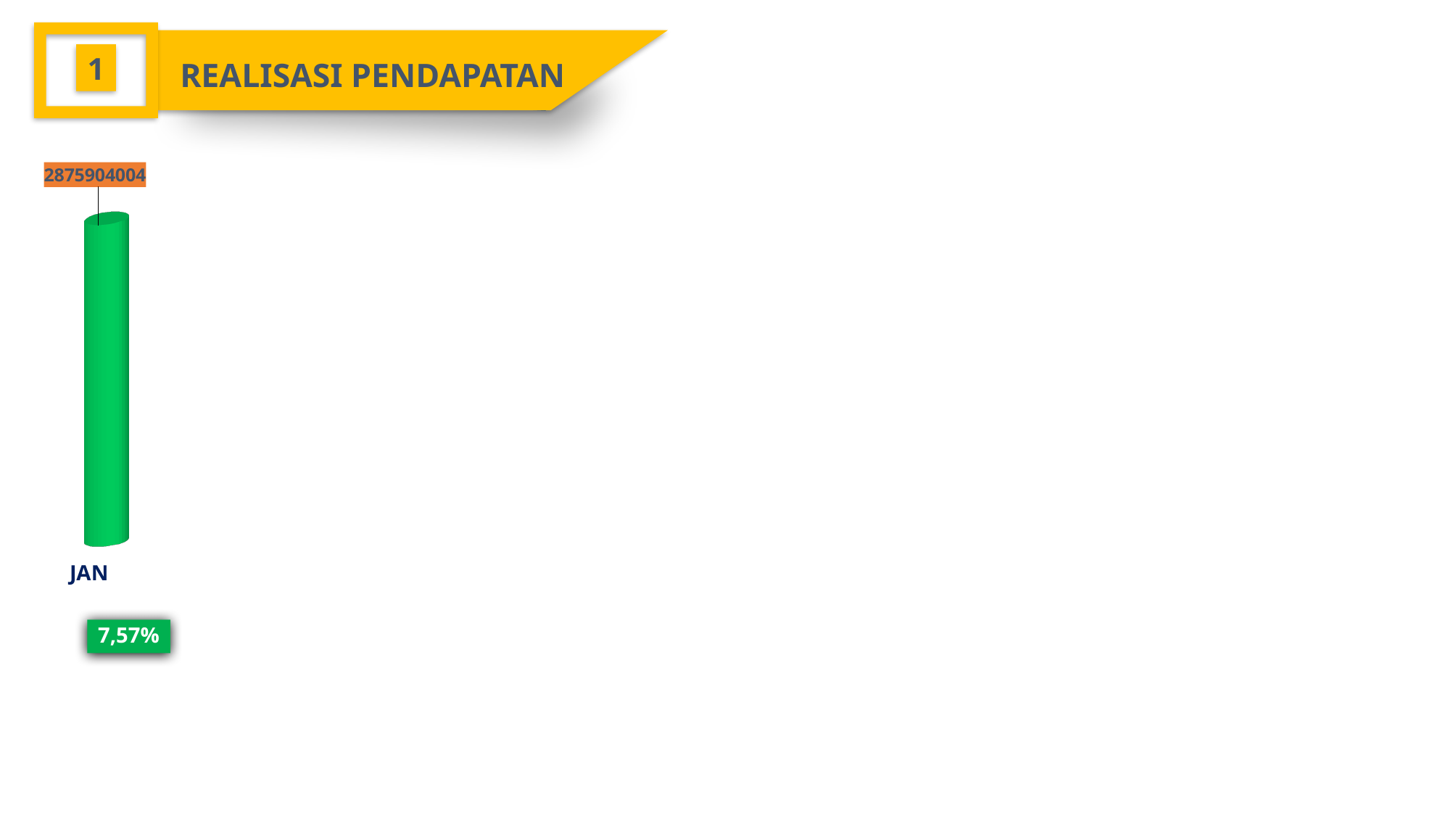
What is the label of the only category on the x axis of the chart? JAN What percentage is shown in the green box below the JAN bar? 7,57% How many categories are plotted on the chart? 1 Is the value for JAN greater or less than 2000000000? greater What is the value shown for JAN on the chart? 2875904004 What colour is the bar for JAN? green What kind of chart is shown on the slide? bar chart